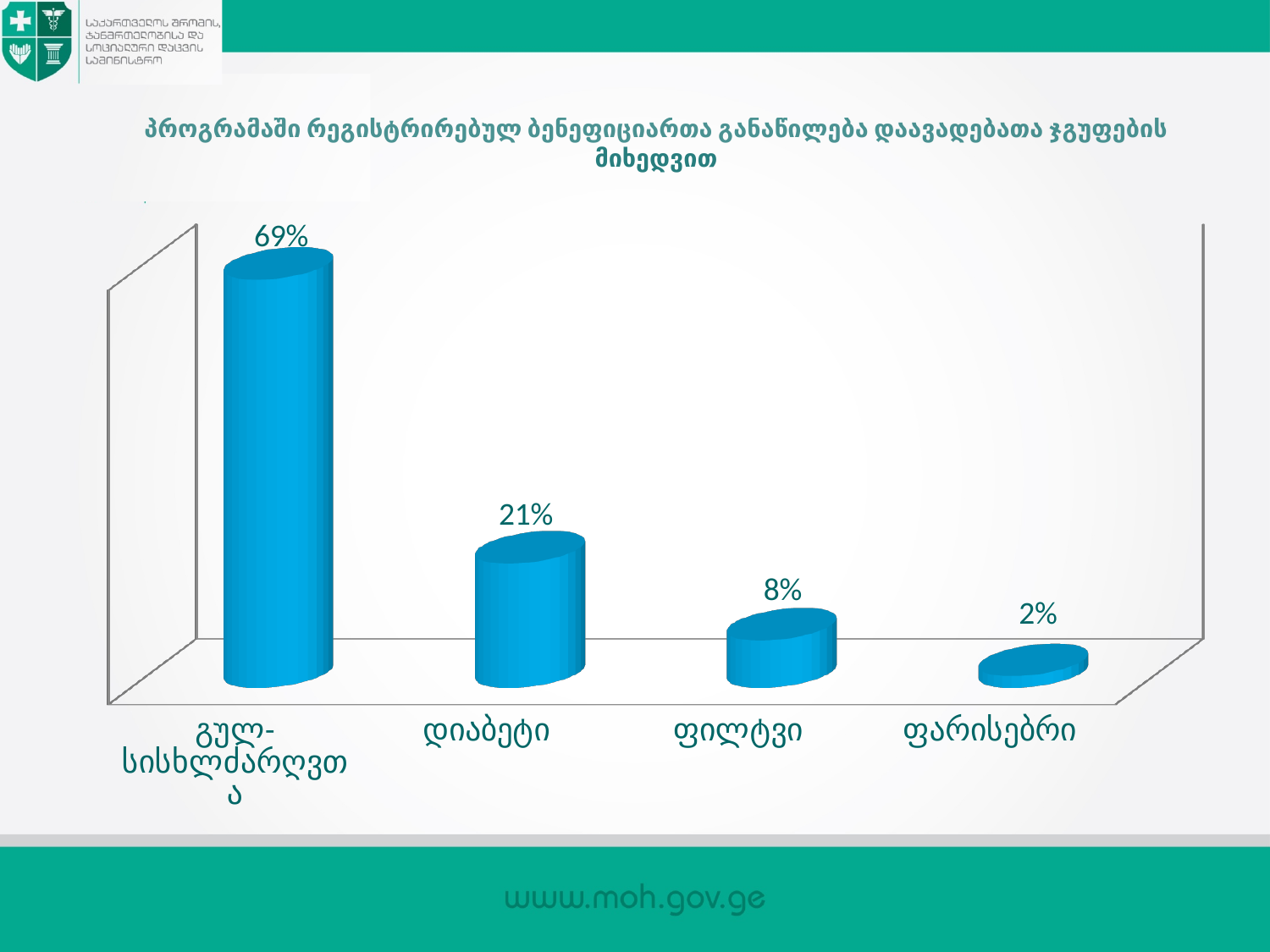
Which is larger, the value for დიაბეტი or the value for ფილტვი? დიაბეტი What is the value for დიაბეტი? 21% How many categories are shown in the chart? 4 What is the difference between the values for ფილტვი and ფარისებრი? 6% What is the difference between the values for გულ-სისხლძარღვთა and დიაბეტი? 48% What is the value for ფილტვი? 8% What is the value for ფარისებრი? 2% Do the values rise or fall from left to right across the categories? Fall Which category has the highest value? გულ-სისხლძარღვთა What is the value for გულ-სისხლძარღვთა? 69% Which category has the lowest value? ფარისებრი What kind of chart is shown on the slide? Bar chart